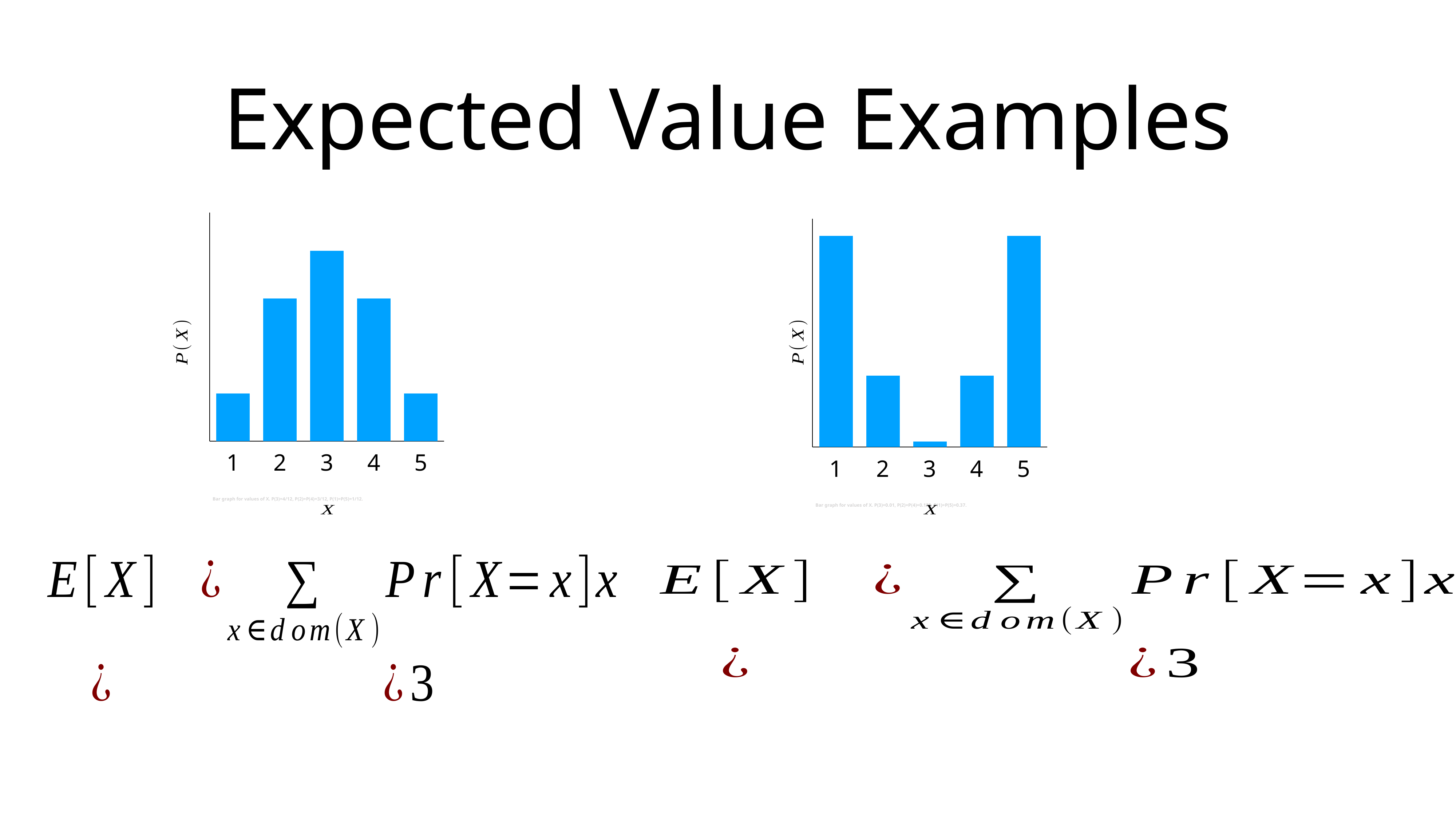
In the left chart, which bar is taller, x = 2 or x = 1? 2 In the right chart, how many categories are shown on the x axis? 5 In the right chart, which value of x has the lowest bar? 3 In the right chart, which bar is taller, x = 1 or x = 2? 1 In the right chart, which bar is taller, x = 3 or x = 4? 4 In the left chart, how many bars are plotted? 5 In the right chart, what is the label on the horizontal axis? x What kind of chart is the right chart on the slide? bar chart In the left chart, what is the label on the vertical axis? P(X) In the left chart, which value of x has the highest bar? 3 What kind of chart is the left chart on the slide? bar chart